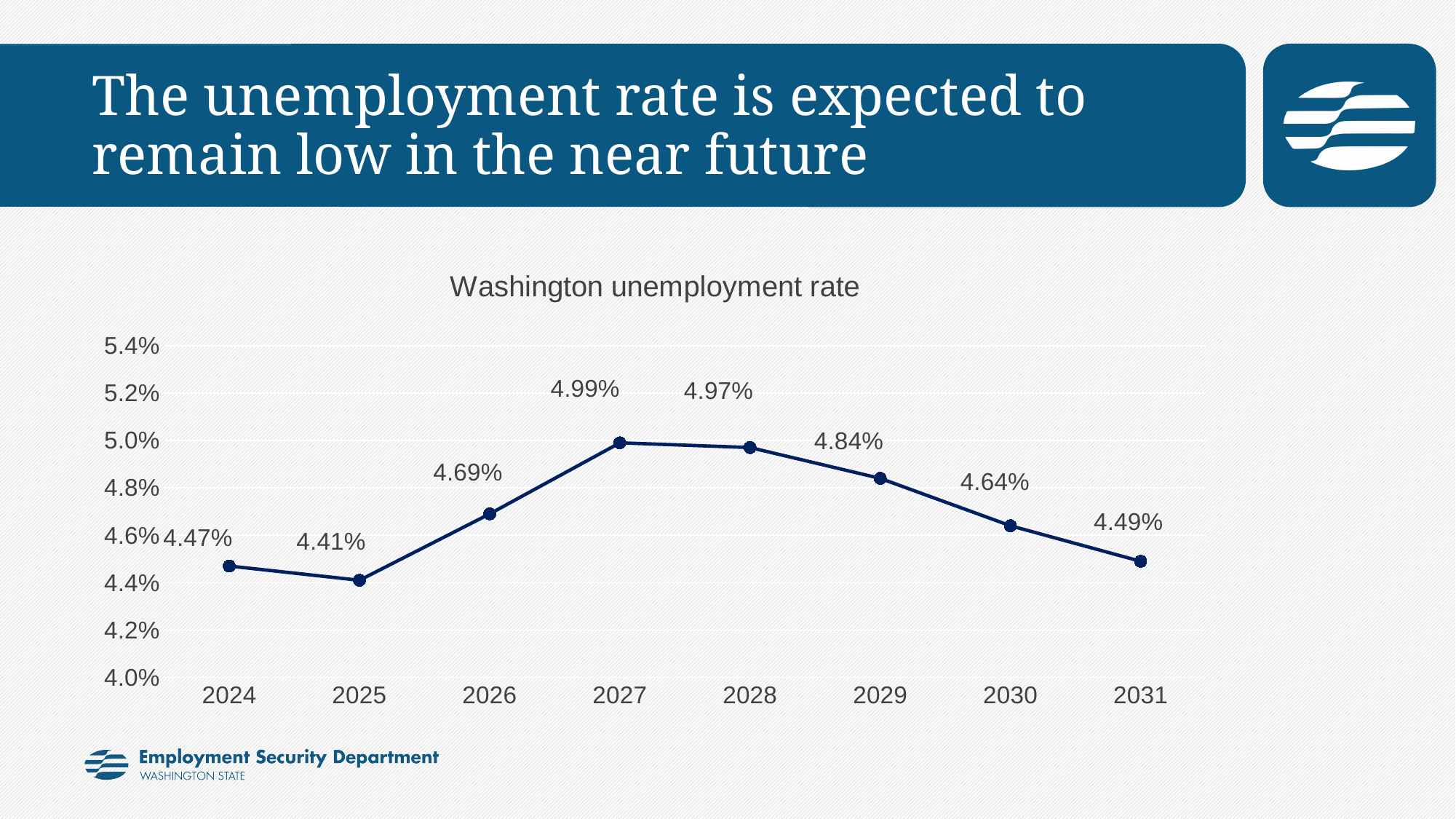
What is the Washington unemployment rate shown for 2031? 4.49% Is the unemployment rate for 2029 greater or less than 5.0%? less What is the Washington unemployment rate shown for 2025? 4.41% Which year has a higher unemployment rate, 2026 or 2030? 2026 Does the unemployment rate rise or fall from 2027 to 2031? Fall What kind of chart is shown on the slide? Line chart Which year has the highest unemployment rate on the chart? 2027 What is the difference between the unemployment rate in 2027 and in 2025? 0.58% What is the title of the chart? Washington unemployment rate How many years are plotted on the chart? 8 What is the Washington unemployment rate shown for 2027? 4.99% Which year has the lowest unemployment rate on the chart? 2025